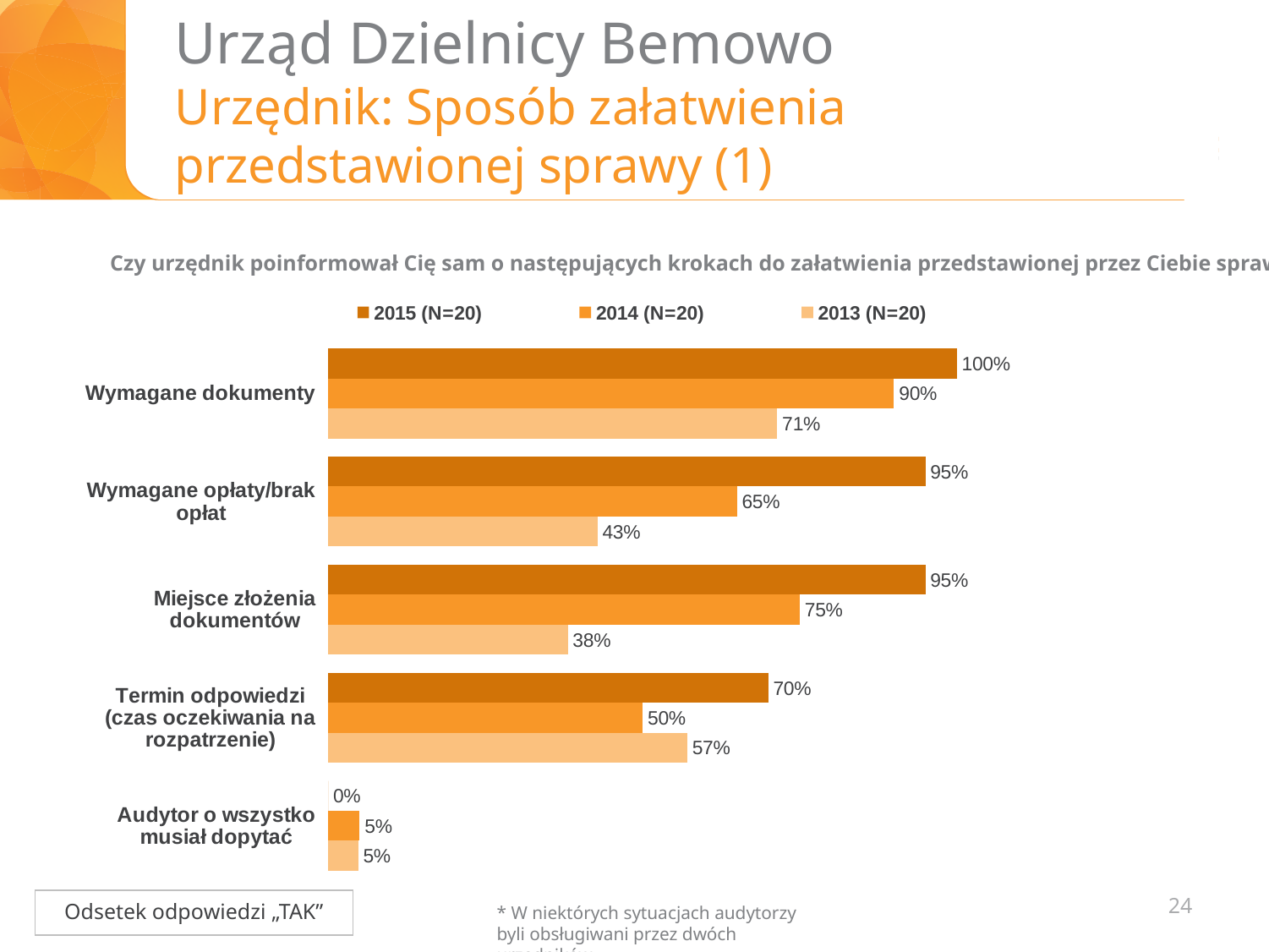
What is the value for "Termin odpowiedzi (czas oczekiwania na rozpatrzenie)" in the 2014 (N=20) series? 50% Which category has the lowest value in the 2014 (N=20) series? Audytor o wszystko musiał dopytać What is the value for "Wymagane dokumenty" in the 2015 (N=20) series? 100% How many categories are shown on the chart? 5 What kind of chart is shown on the slide? bar chart Which series is shown in the darkest orange colour? 2015 (N=20) What is the value for "Audytor o wszystko musiał dopytać" in the 2015 (N=20) series? 0% What is the value for "Miejsce złożenia dokumentów" in the 2013 (N=20) series? 38% For "Termin odpowiedzi (czas oczekiwania na rozpatrzenie)", which is larger: the 2014 (N=20) value or the 2013 (N=20) value? 2013 (N=20) Which category has the highest value in the 2015 (N=20) series? Wymagane dokumenty What is the difference between the 2015 (N=20) and 2013 (N=20) values for "Wymagane opłaty/brak opłat"? 52% How many series does the legend list? 3